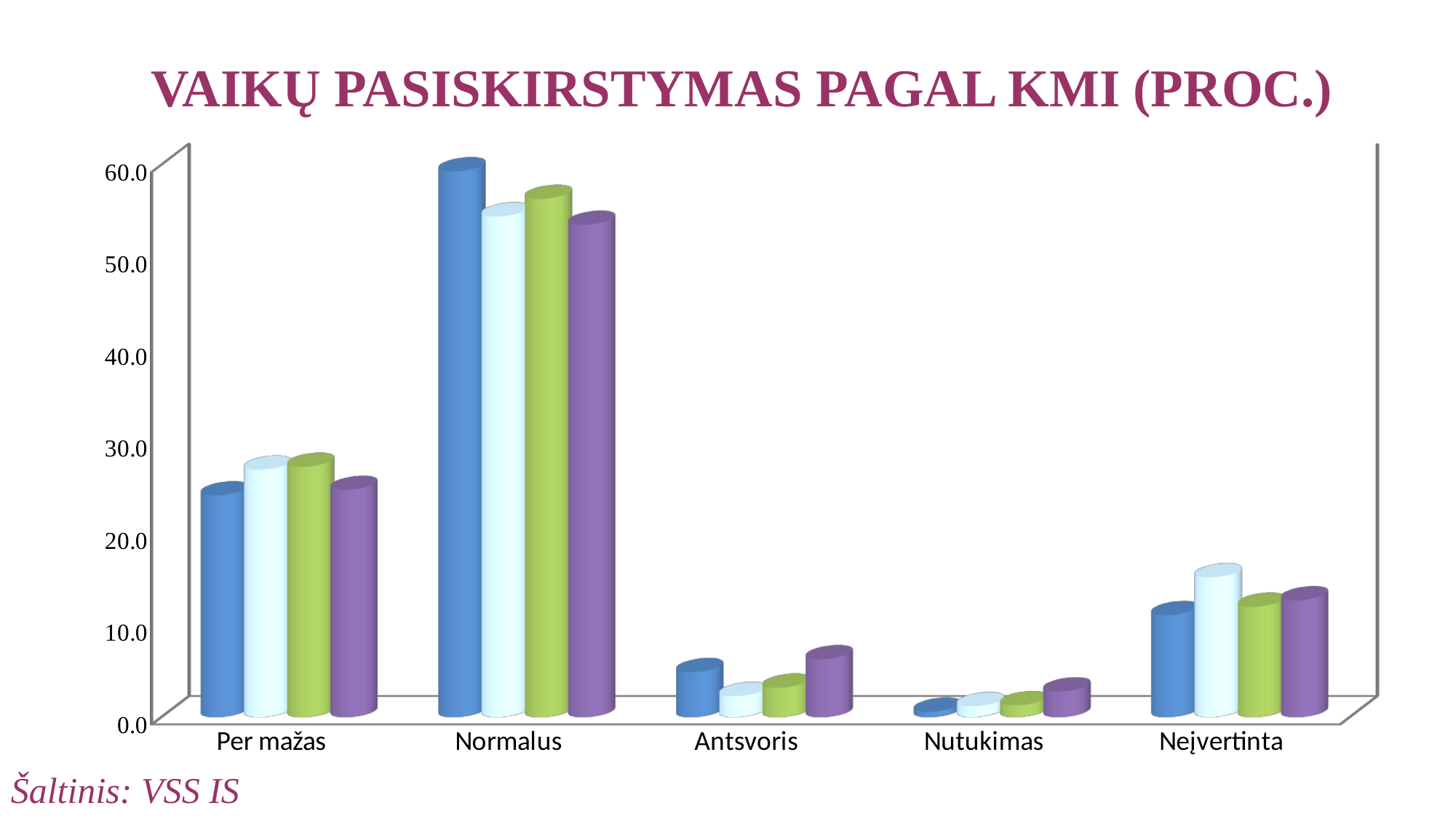
What kind of chart is shown on the slide? bar chart Is the value of the blue bar for Per mažas greater or less than 20? greater How many categories are shown on the x axis of the chart? 5 Which category has larger values, Per mažas or Neįvertinta? Per mažas Is the value of the light blue bar for Neįvertinta greater or less than 10? greater What is the title of the chart? VAIKŲ PASISKIRSTYMAS PAGAL KMI (PROC.) Is the value of the blue bar for Normalus greater or less than 50? greater How many bars are plotted for each category in the chart? 4 Which category has larger values, Antsvoris or Nutukimas? Antsvoris Which category has the highest bars in the chart? Normalus Which category has the lowest bars in the chart? Nutukimas